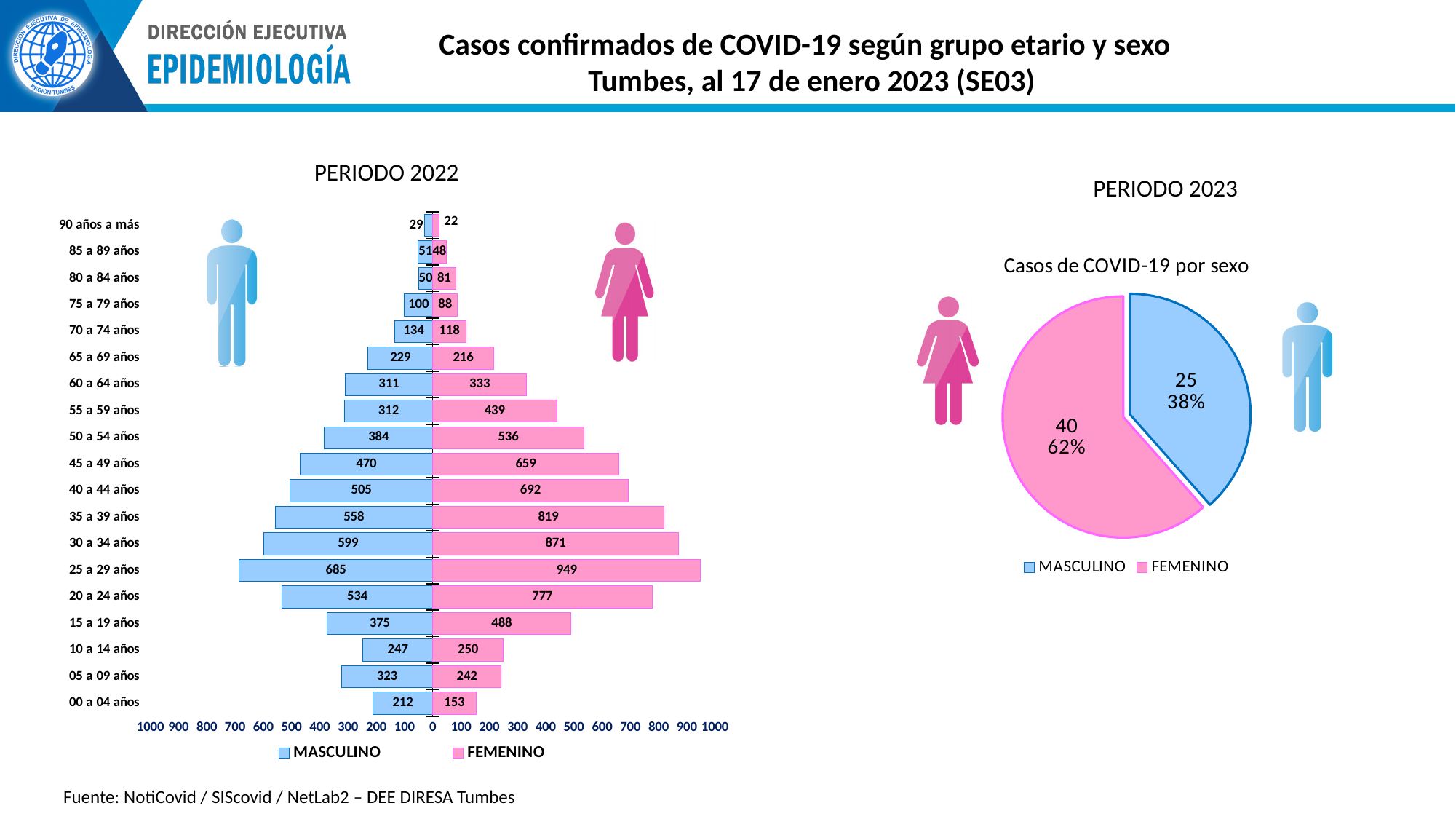
In the PERIODO 2022 chart, what is the difference between the FEMENINO and MASCULINO values for the 30 a 34 años group? 272 In the PERIODO 2023 pie chart, how many MASCULINO cases are shown? 25 What kind of chart is the PERIODO 2022 chart? Bar chart In the PERIODO 2022 chart, how many series does the legend list? 2 In the PERIODO 2023 pie chart, what share of cases is FEMENINO? 62% What is the title shown above the PERIODO 2023 pie chart? Casos de COVID-19 por sexo In the PERIODO 2022 chart, for the 05 a 09 años group, which is larger: MASCULINO or FEMENINO? MASCULINO In the PERIODO 2022 chart, which age group has the lowest MASCULINO value? 90 años a más In the PERIODO 2022 chart, which age group has the highest FEMENINO value? 25 a 29 años In the PERIODO 2022 chart, how many FEMENINO cases are shown for the 25 a 29 años group? 949 In the PERIODO 2022 chart, how many MASCULINO cases are shown for the 45 a 49 años group? 470 In the PERIODO 2022 chart, how many age groups are shown? 19